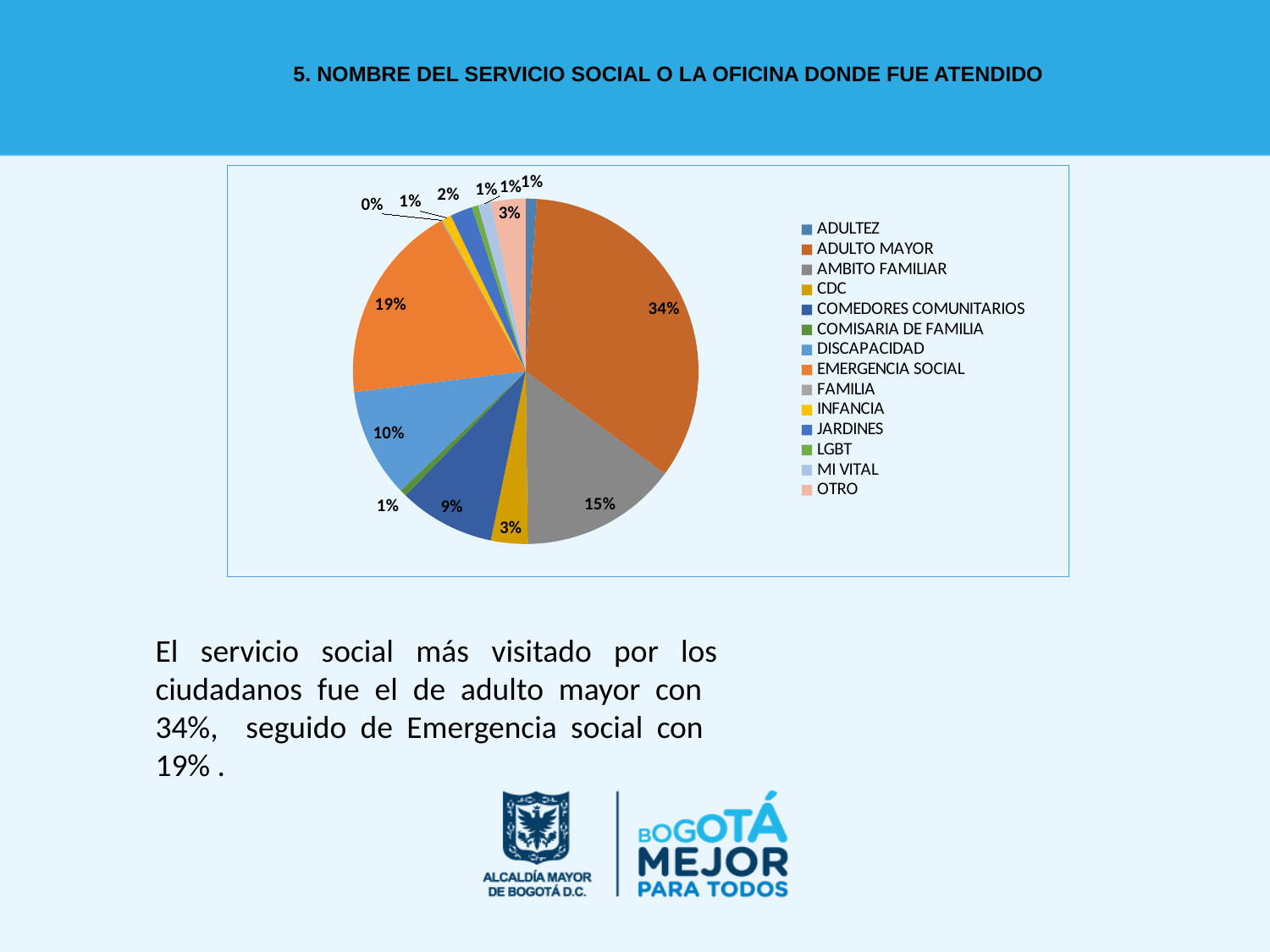
What is the value shown for COMEDORES COMUNITARIOS? 9% What is the title of the slide above the chart? 5. NOMBRE DEL SERVICIO SOCIAL O LA OFICINA DONDE FUE ATENDIDO Which is larger, the slice for AMBITO FAMILIAR or the slice for DISCAPACIDAD? AMBITO FAMILIAR What is the value shown for AMBITO FAMILIAR? 15% What share of the pie does ADULTO MAYOR represent? 34% Which category has the smallest slice, labelled 0%? FAMILIA How many categories does the legend list? 14 Which category has the largest slice of the pie? ADULTO MAYOR What is the value shown for DISCAPACIDAD? 10% What is the difference in percentage points between ADULTO MAYOR and EMERGENCIA SOCIAL? 15 percentage points What kind of chart is shown on the slide? Pie chart What share of the pie does EMERGENCIA SOCIAL represent? 19%